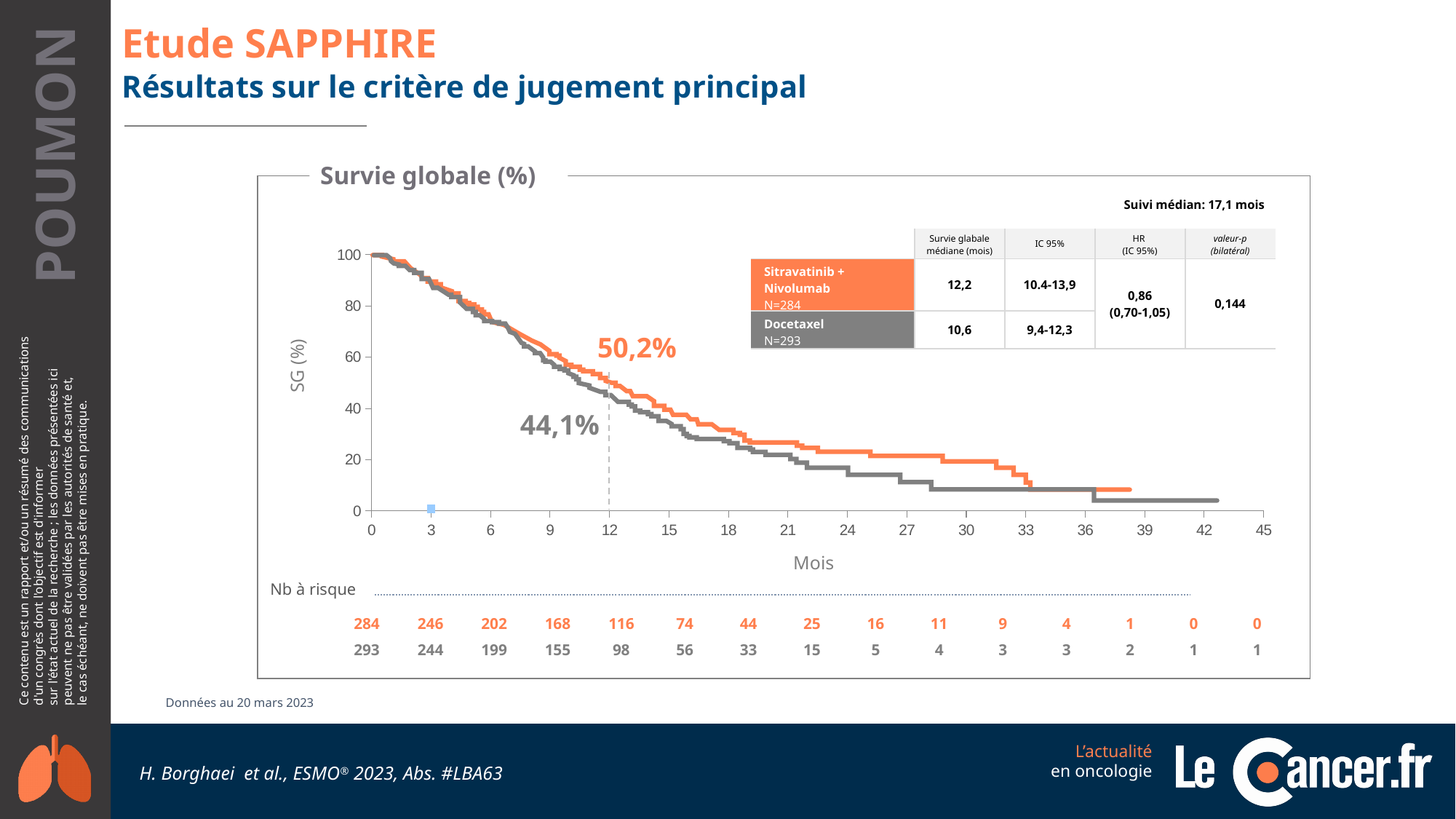
How many patients were at risk at 12 months in the Docetaxel arm? 98 Do the survival curves rise or fall as months increase along the x axis? fall How many treatment arms (series) are plotted on the chart? 2 What is the overall survival rate at 12 months for the Docetaxel arm? 44,1% What is the median overall survival in months for the Sitravatinib + Nivolumab arm shown in the table? 12,2 How many patients were at risk at 0 months in the Sitravatinib + Nivolumab arm? 284 What is the overall survival rate at 12 months for the Sitravatinib + Nivolumab arm? 50,2% What kind of chart is shown on the slide? line chart (Kaplan-Meier survival curve) Is the overall survival for the Docetaxel arm at 24 months greater or less than 40? less Which arm has the higher overall survival rate at 12 months? Sitravatinib + Nivolumab What is the title of the chart? Survie globale (%) What is the difference in 12-month overall survival between the Sitravatinib + Nivolumab arm and the Docetaxel arm? 6,1 percentage points